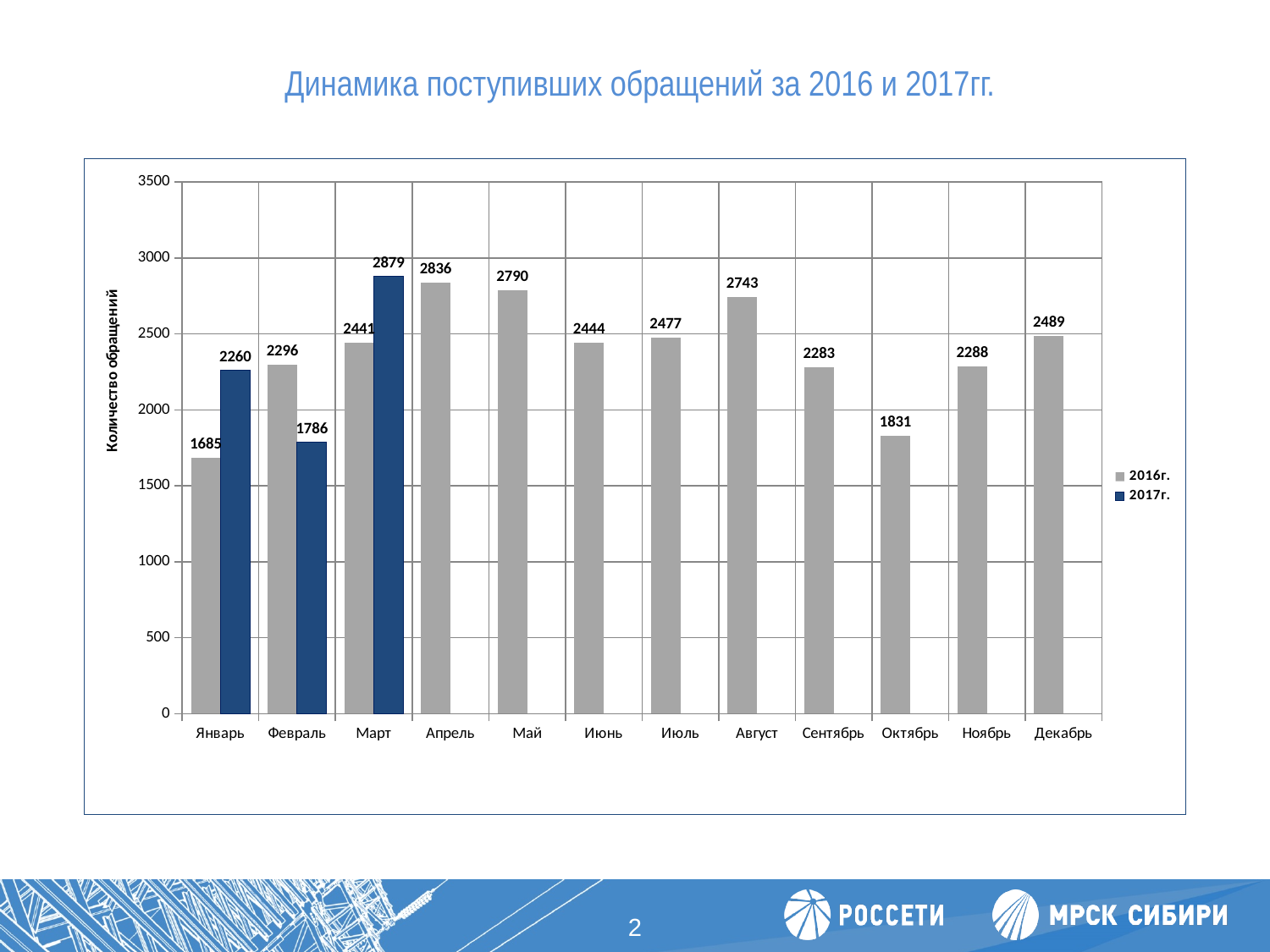
What is the value for Октябрь in the 2016г. series? 1831 What is the difference between the 2016г. and 2017г. values for Февраль? 510 Which month has the highest value in the 2016г. series? Апрель What is the value for Январь in the 2016г. series? 1685 What is the value for Март in the 2017г. series? 2879 Which month has the lowest value in the 2016г. series? Январь What is the difference between the 2017г. and 2016г. values for Январь? 575 Is the 2016г. value for Август greater or less than 2500? greater How many months are shown on the x axis? 12 What kind of chart is shown on the slide? bar chart Which is larger for Февраль: the 2016г. value or the 2017г. value? 2016г. How many series does the legend list? 2